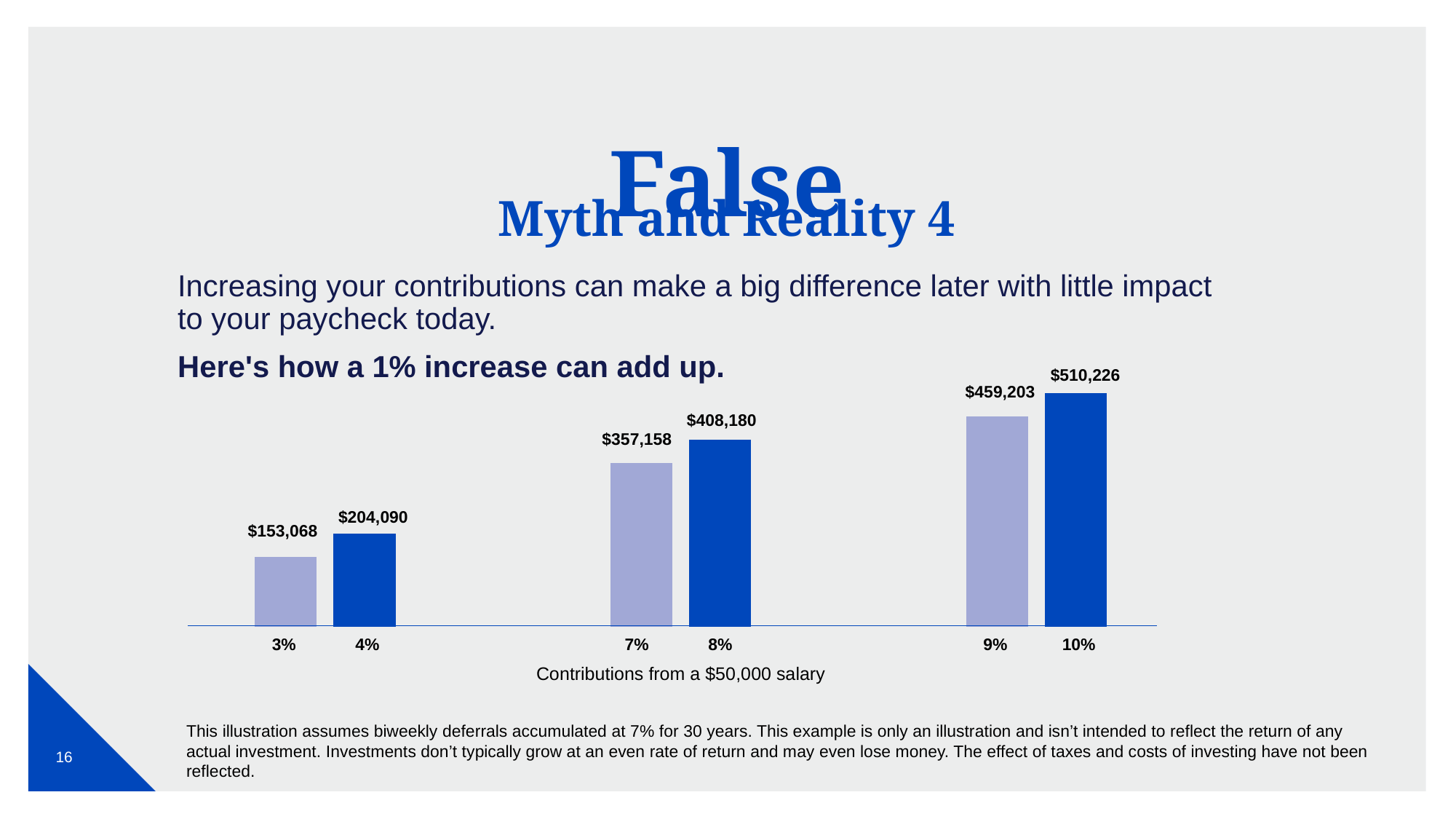
What kind of chart is shown on the slide? Bar chart How many bars are plotted in the chart? 6 Which contribution rate has the lowest value in the chart? 3% Which is larger, the value for 7% or the value for 4%? 7% What is the label shown beneath the x axis of the chart? Contributions from a $50,000 salary Which contribution rate has the highest value in the chart? 10% What is the difference between the values for the 4% and 3% contribution bars? $51,022 Do the values rise or fall as the contribution rate increases along the x axis? Rise What value is shown for the 10% contribution bar? $510,226 What value is shown for the 3% contribution bar? $153,068 What value is shown for the 8% contribution bar? $408,180 What is the difference between the values for the 10% and 9% contribution bars? $51,023